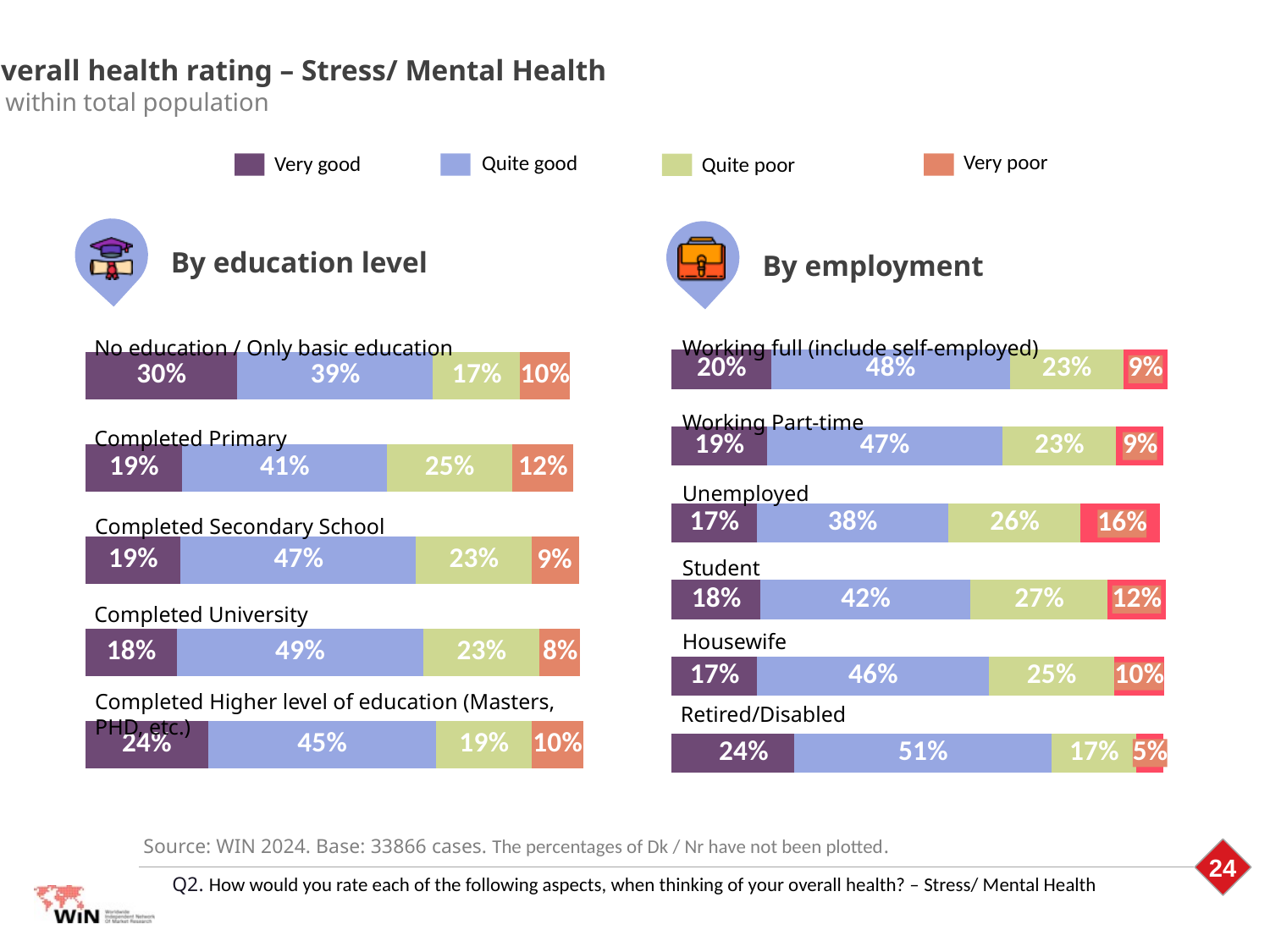
In the 'By education level' chart, what is the total of the plotted percentages for the 'No education / Only basic education' bar? 96% How many education levels are shown in the 'By education level' chart? 5 In the 'By education level' chart, which has a larger 'Quite good' share: Completed University or Completed Primary? Completed University In the 'By employment' chart, what is the 'Very poor' value for Unemployed? 16% In the 'By education level' chart, what percentage of people with no education / only basic education rated their stress/mental health as 'Very good'? 30% How many employment groups are shown in the 'By employment' chart? 6 In the 'By employment' chart, what is the 'Quite good' value for Retired/Disabled? 51% In the 'By employment' chart, what is the difference in percentage points between the 'Very poor' values for Unemployed and Retired/Disabled? 11 percentage points In the 'By education level' chart, which education level has the highest 'Very good' share? No education / Only basic education In the 'By employment' chart, which employment group has the lowest 'Very poor' share? Retired/Disabled How many rating categories does the legend list? 4 In the 'By employment' chart, which employment group has the highest 'Quite good' share? Retired/Disabled